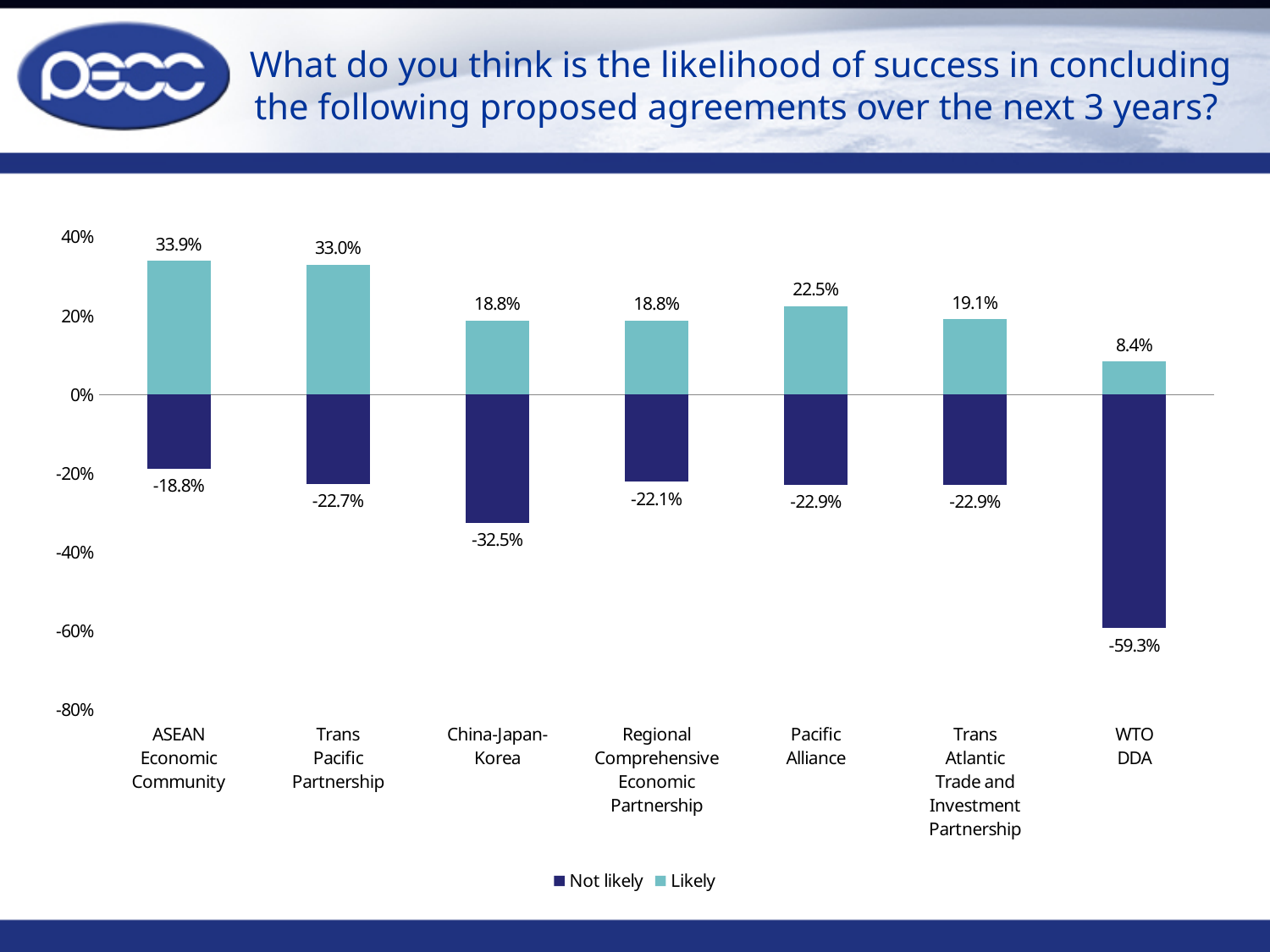
What is the 'Likely' value for Pacific Alliance? 22.5% Which series is shown in dark blue? Not likely How many series does the legend list? 2 How many agreements are shown on the x axis? 7 What is the difference between the 'Likely' values for ASEAN Economic Community and Trans Pacific Partnership? 0.9% What is the 'Likely' value for ASEAN Economic Community? 33.9% What kind of chart is shown on the slide? Bar chart What is the 'Not likely' value for WTO DDA? -59.3% What is the 'Not likely' value for China-Japan-Korea? -32.5% Which agreement has the highest 'Likely' value? ASEAN Economic Community Which agreement has the lowest 'Likely' value? WTO DDA Which has a larger 'Likely' value, Pacific Alliance or Trans Atlantic Trade and Investment Partnership? Pacific Alliance